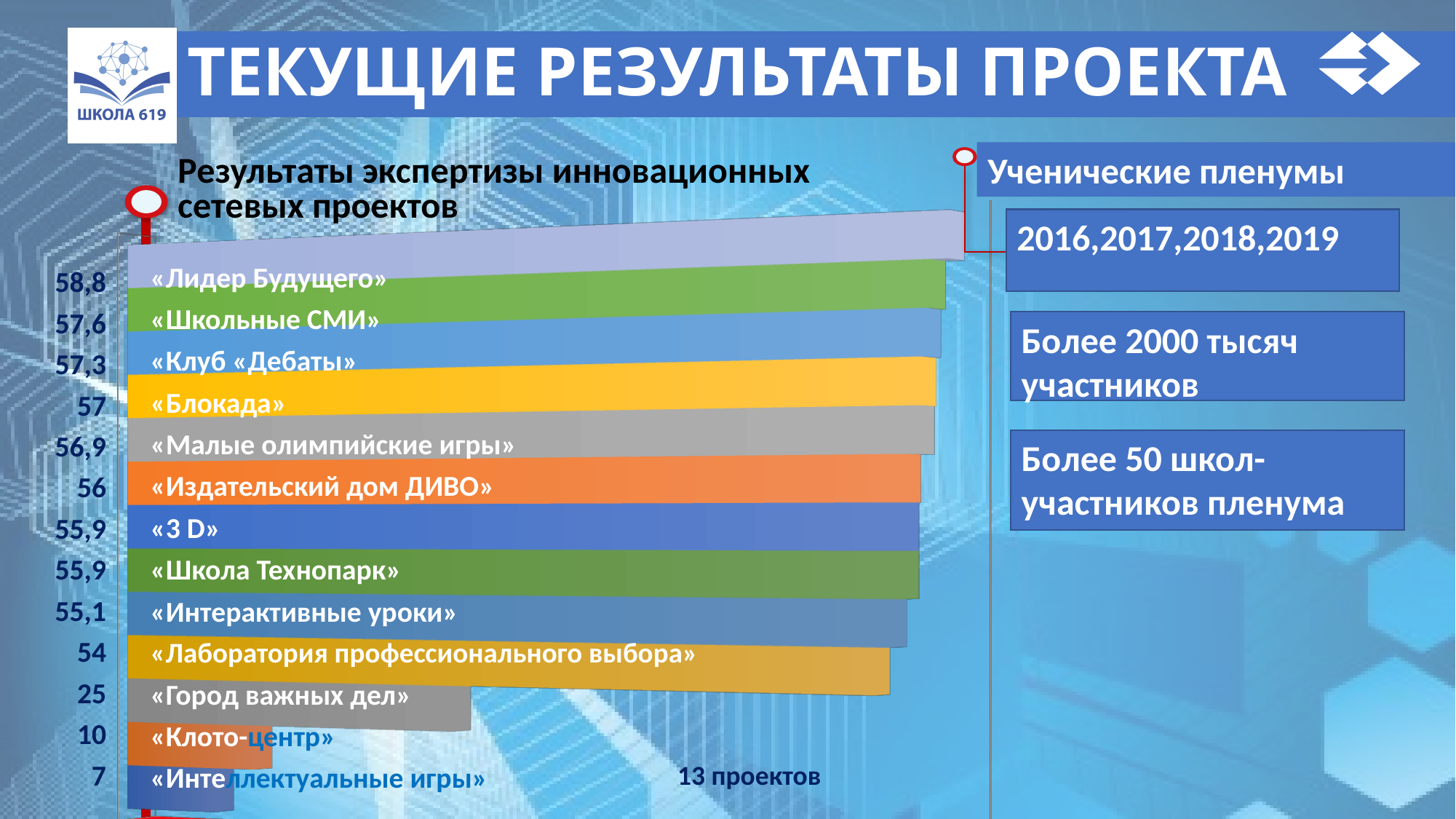
Which has a larger value, «Блокада» or «Город важных дел»? «Блокада» What value is shown for «Город важных дел»? 25 What is the difference between the values for «Лидер Будущего» and «Интеллектуальные игры»? 51,8 Which project has the lowest value in the chart? «Интеллектуальные игры» How many projects are shown in the chart? 13 What is the title of the chart on the left of the slide? Результаты экспертизы инновационных сетевых проектов Which project has the highest value in the chart? «Лидер Будущего» What value is shown for «Лаборатория профессионального выбора»? 54 What value is shown for «Клото-центр»? 10 What value is shown for «Лидер Будущего» in the chart «Результаты экспертизы инновационных сетевых проектов»? 58,8 What is the difference between the values for «Город важных дел» and «Клото-центр»? 15 What kind of chart is used to show the results of the expert review of innovative network projects? Bar chart